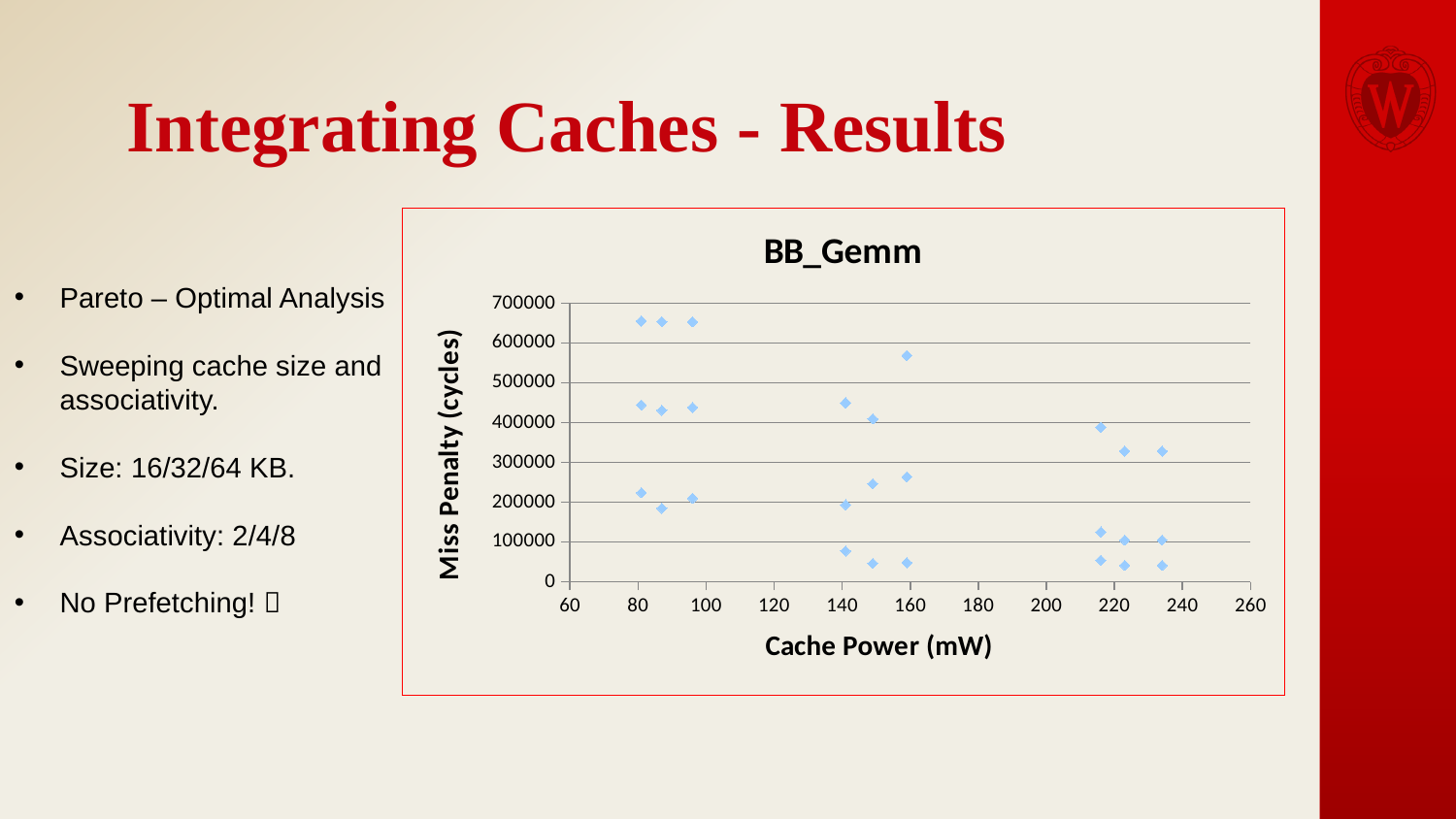
Is the smallest cache power value plotted on the chart greater or less than 100 mW? less Is the lowest miss penalty plotted on the chart greater or less than 100000 cycles? less Is the largest cache power value plotted on the chart greater or less than 220 mW? greater How many data points are plotted on the chart? 27 What kind of chart is shown on the slide? scatter chart What is the label of the x axis of the chart? Cache Power (mW) What is the highest tick value shown on the y axis of the chart? 700000 What is the title of the chart? BB_Gemm